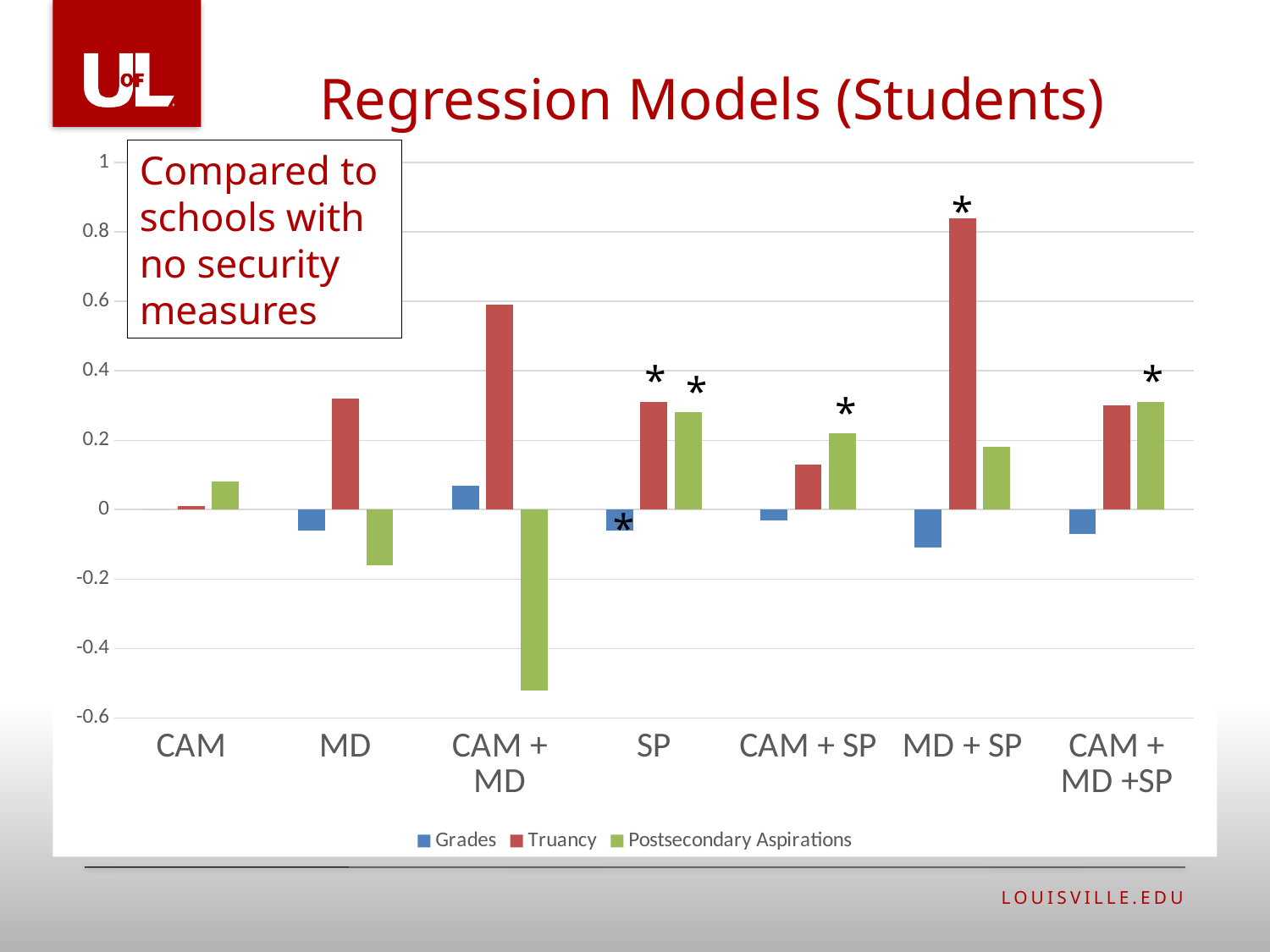
Which category has the lowest Postsecondary Aspirations value? CAM + MD Is the Grades value for MD + SP greater or less than 0? less Which is larger, the Truancy value for CAM + MD or the Truancy value for CAM + SP? CAM + MD What kind of chart is shown on the slide? bar chart Which is larger, the Postsecondary Aspirations value for CAM or the Postsecondary Aspirations value for MD? CAM What is the title of the chart? Regression Models (Students) How many series does the legend list? 3 How many categories are shown on the x axis? 7 Is the Truancy value for MD + SP greater or less than 0.8? greater Is the Postsecondary Aspirations value for CAM + MD greater or less than -0.4? less Which category has the highest Truancy value? MD + SP